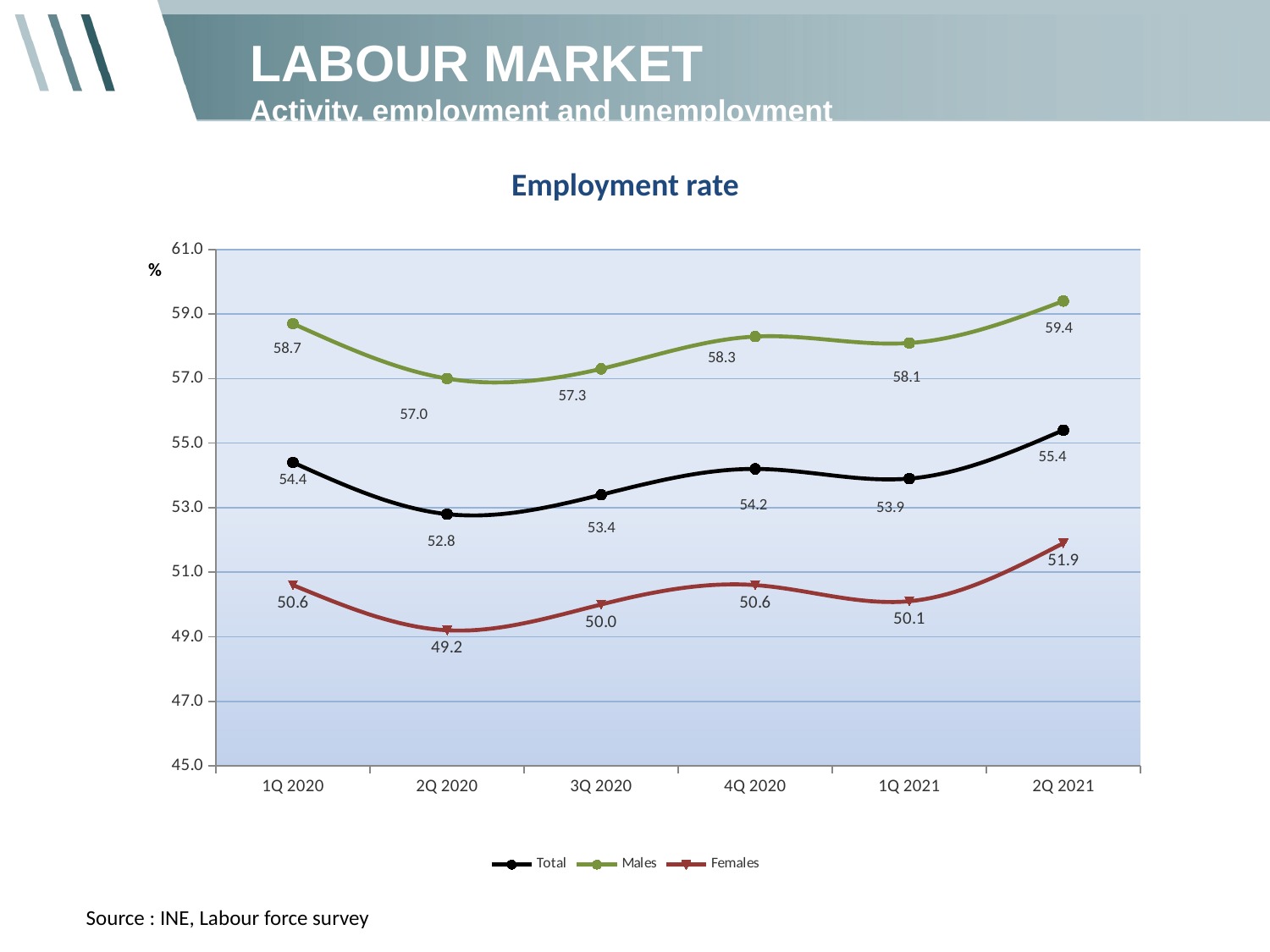
In which quarter is the Total employment rate lowest? 2Q 2020 What kind of chart is shown on the slide? Line chart In which quarter is the Females employment rate highest? 2Q 2021 What is the employment rate for Males in 2Q 2021? 59.4 Which is larger: the Total employment rate in 1Q 2020 or in 2Q 2021? 2Q 2021 How many series does the legend list? 3 What is the title of the chart? Employment rate How many quarters are shown on the x axis? 6 What is the difference between the Males and Females employment rates in 1Q 2021? 8.0 Does the Males employment rate rise or fall from 1Q 2021 to 2Q 2021? Rise What is the Total employment rate in 4Q 2020? 54.2 What is the employment rate for Females in 2Q 2020? 49.2